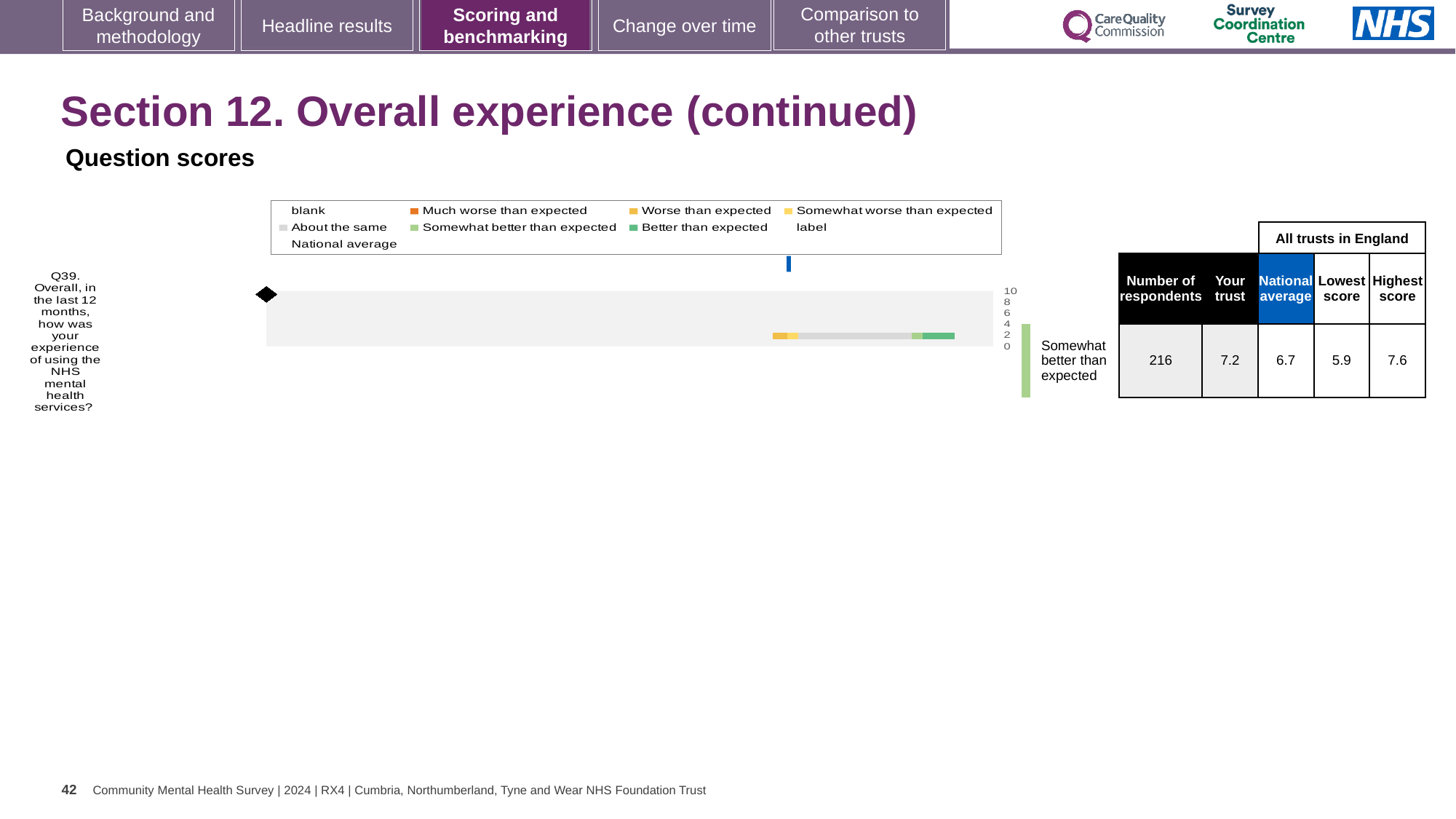
In the table beside the chart, what is the 'Your trust' score for Q39? 7.2 What is the difference between the 'Your trust' score and the national average for Q39? 0.5 In the table beside the chart, what is the lowest score among all trusts in England for Q39? 5.9 In the table beside the chart, how many respondents answered Q39? 216 How many questions (categories) are plotted in the chart? 1 What benchmark category label is shown next to the bar for Q39? Somewhat better than expected How many entries does the chart legend list? 9 What kind of chart is shown on the slide? bar chart In the table beside the chart, what is the highest score among all trusts in England for Q39? 7.6 In the table beside the chart, what is the national average score for Q39? 6.7 Which question is plotted in the chart? Q39. Overall, in the last 12 months, how was your experience of using the NHS mental health services? Which is larger for Q39, the 'Your trust' score or the national average? Your trust